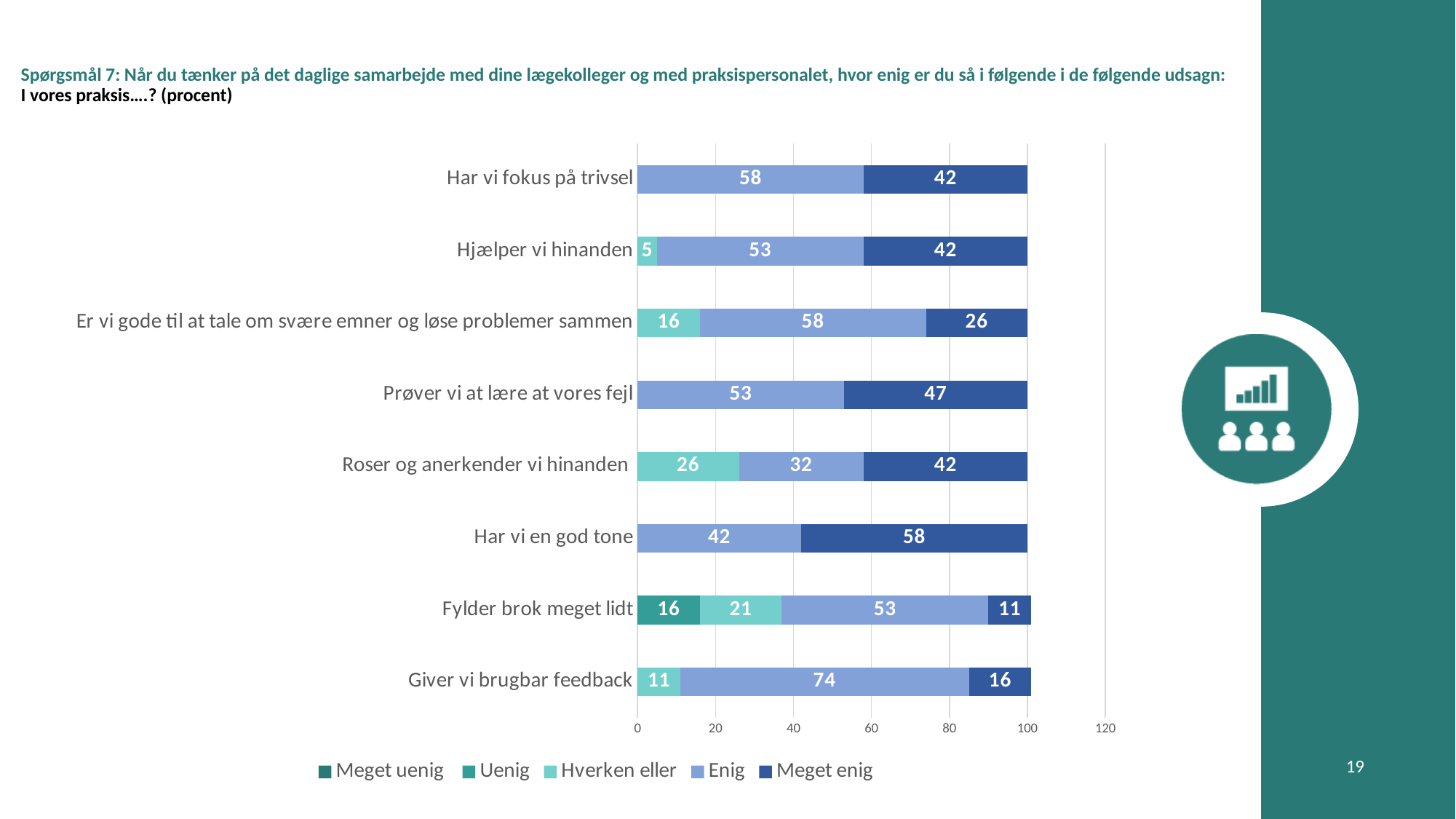
What is the value of the "Meget enig" segment for "Prøver vi at lære at vores fejl"? 47 What is the total of the stacked bar for "Fylder brok meget lidt"? 101 How many series does the legend list? 5 Which statement has the highest "Enig" value? Giver vi brugbar feedback What kind of chart is shown on the slide? Stacked bar chart Which statement has the highest "Meget enig" value? Har vi en god tone What is the value of the "Enig" segment for "Giver vi brugbar feedback"? 74 Which is larger for "Er vi gode til at tale om svære emner og løse problemer sammen": the "Enig" value or the "Meget enig" value? Enig What is the value of the "Hverken eller" segment for "Roser og anerkender vi hinanden"? 26 How many statements (categories) are shown in the chart? 8 For "Har vi en god tone", what is the difference between the "Meget enig" and "Enig" values? 16 Which statement has the lowest "Meget enig" value? Fylder brok meget lidt